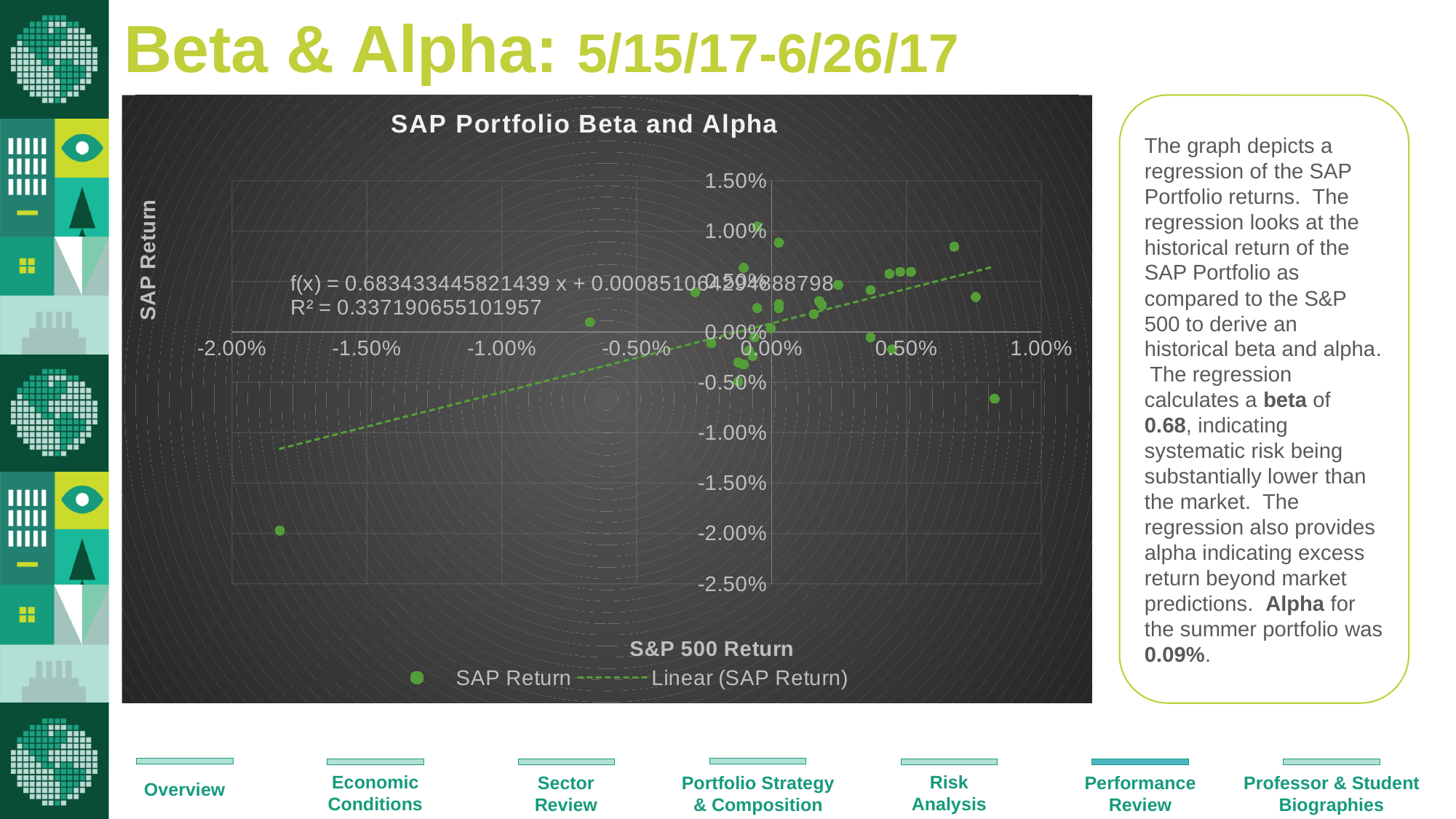
What kind of chart is shown on the slide? Scatter chart Is the lowest point on the chart located at an S&P 500 Return greater or less than -1.50%? less What is the lowest value shown on the vertical axis of the chart? -2.50% What R² value is displayed on the chart? 0.337190655101957 How many entries does the chart legend list? 2 What is the title of the chart? SAP Portfolio Beta and Alpha Is the lowest SAP Return point on the chart greater or less than -1.50%? less Is the highest SAP Return point on the chart greater or less than 0.50%? greater What is the label of the horizontal axis of the chart? S&P 500 Return What is the slope (coefficient of x) shown in the trendline equation on the chart? 0.683433445821439 Does the dashed trendline rise or fall as the S&P 500 Return increases? Rises What is the highest value shown on the horizontal axis of the chart? 1.00%